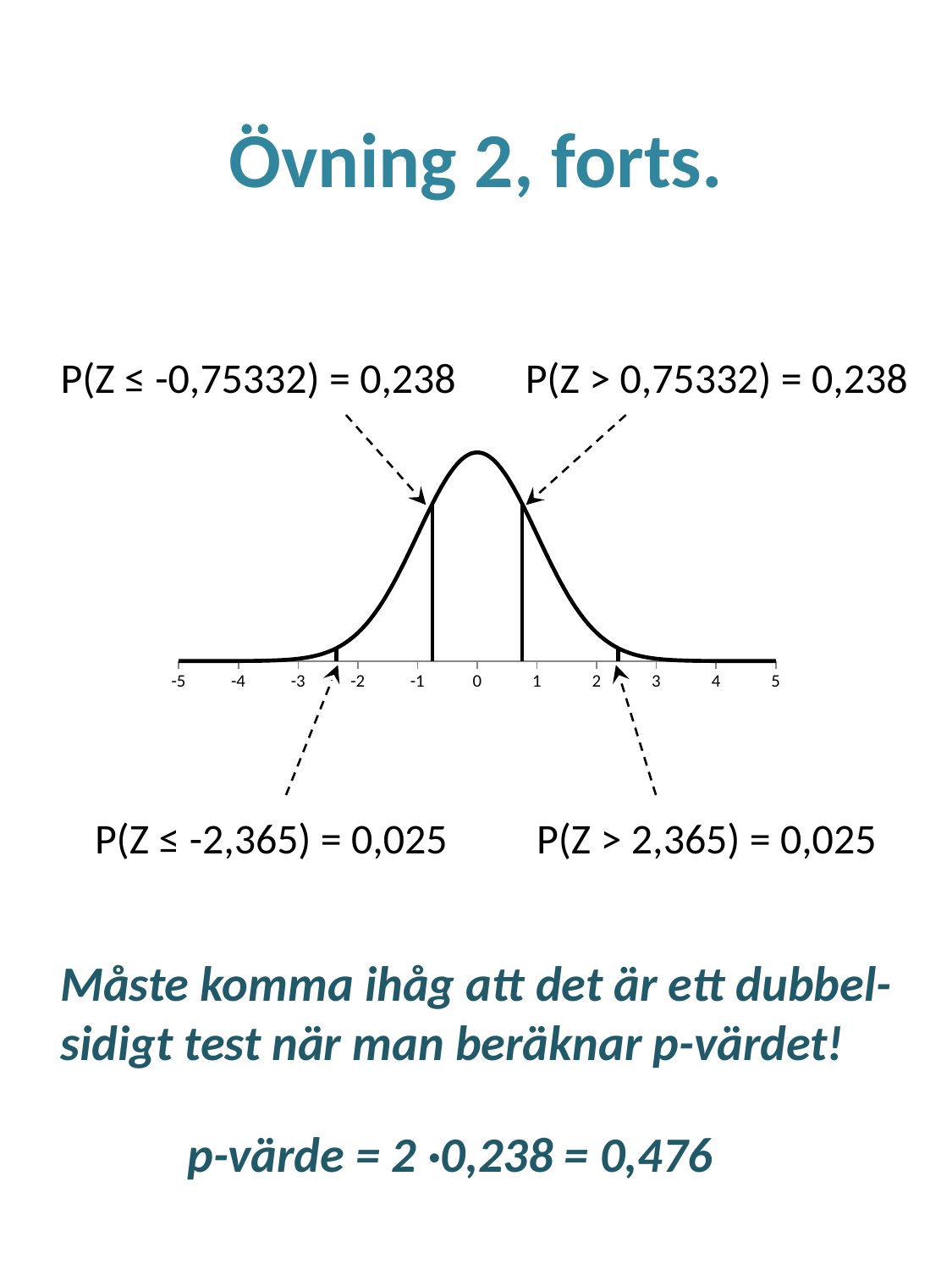
Which is larger, P(Z > 0,75332) or P(Z > 2,365)? P(Z > 0,75332) What is the value of P(Z > 0,75332) shown on the slide? 0,238 What is the sum of P(Z ≤ -0,75332) and P(Z > 0,75332), i.e. the p-value shown on the slide? 0,476 How many tick labels are shown on the x axis of the chart? 11 What is the value of P(Z ≤ -0,75332) shown on the slide? 0,238 What is the difference between P(Z > 0,75332) and P(Z > 2,365)? 0,213 What are the lowest and highest values labelled on the x axis? -5 and 5 What is the value of P(Z > 2,365) shown on the slide? 0,025 At which x-axis value does the curve reach its peak? 0 Does the curve rise or fall as x goes from 0 to 5? Falls What is the title of the slide containing the chart? Övning 2, forts. What kind of chart is shown on the slide? A line chart (normal distribution curve)